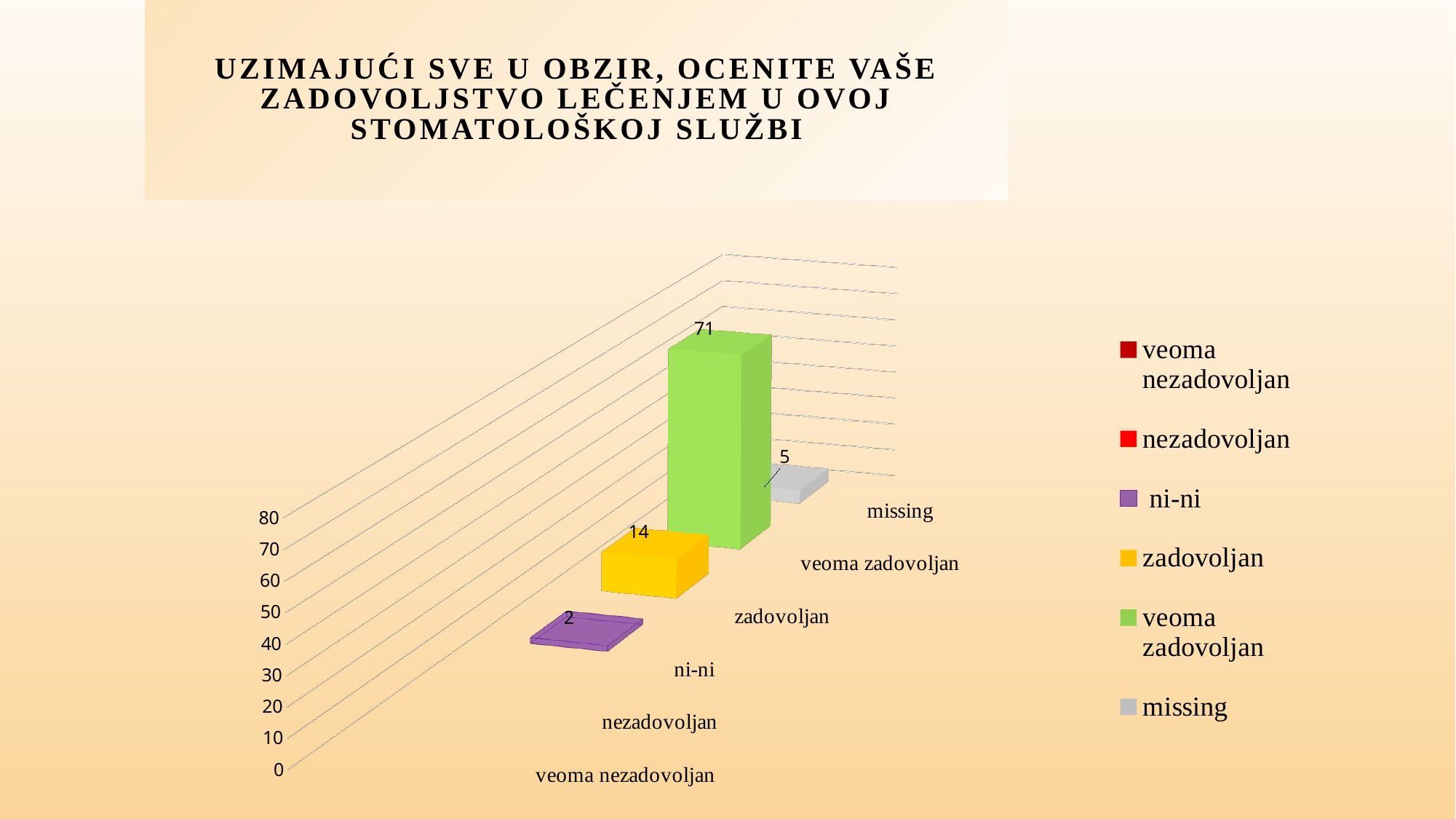
Which is larger, the value for zadovoljan or the value for missing? zadovoljan What is the value for zadovoljan? 14 Which category has the highest value? veoma zadovoljan What is the difference between the values for zadovoljan and missing? 9 Is the value for veoma zadovoljan greater or less than 50? greater What kind of chart is shown on the slide? bar chart How many categories are shown on the category axis? 6 What is the value for missing? 5 What is the difference between the values for veoma zadovoljan and zadovoljan? 57 What is the value for veoma zadovoljan? 71 What is the value for ni-ni? 2 How many entries does the legend list? 6